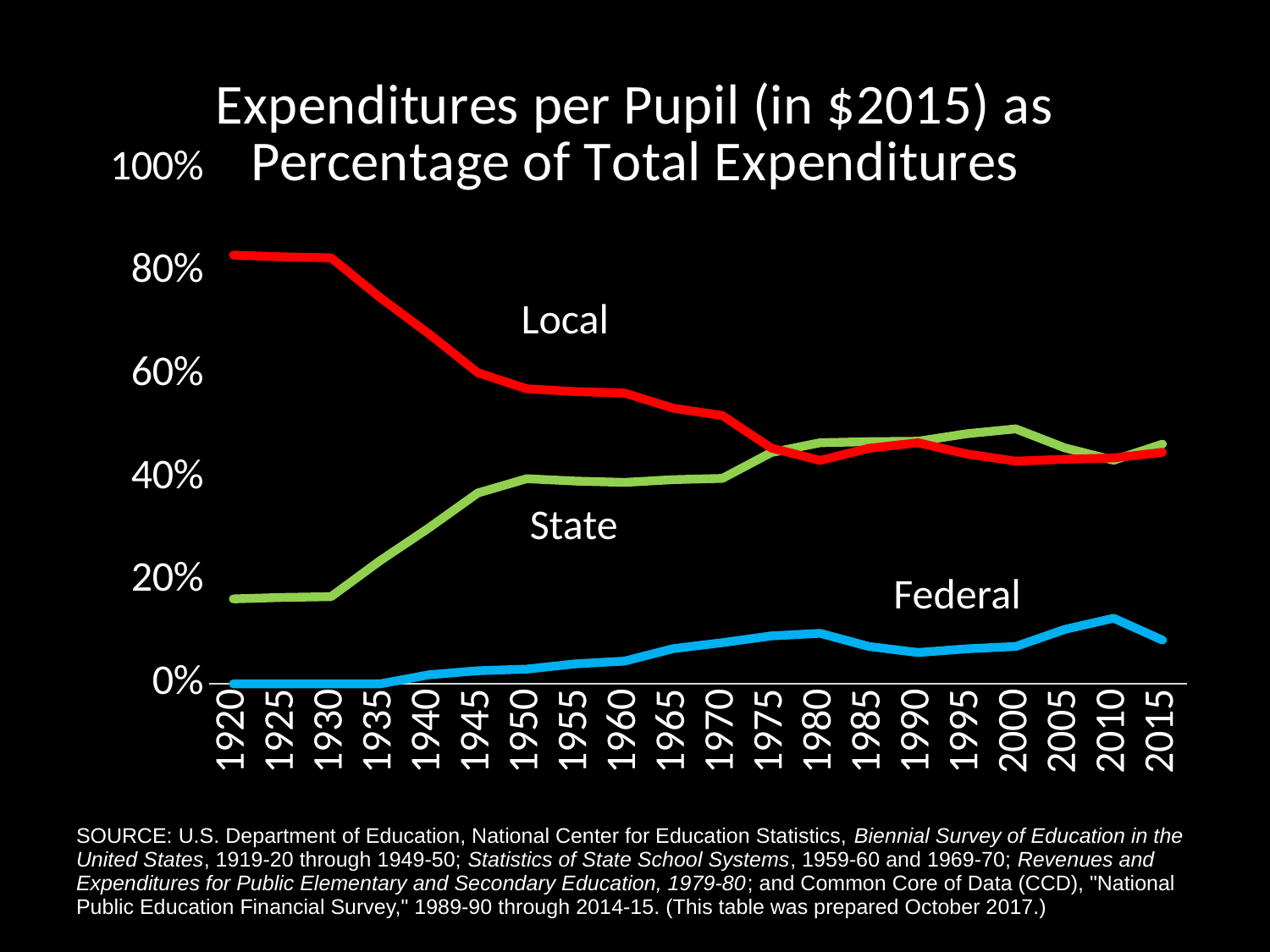
How many series are plotted on the chart? 3 What kind of chart is shown on the slide? line chart Is the value for Local in 1920 greater or less than 60%? greater Does the Local series rise or fall from 1920 to 2015? fall In 2015, which is larger, the State value or the Federal value? State Does the State series rise or fall from 1920 to 2015? rise Is the value for State in 1920 greater or less than 20%? less What colour is the Local line on the chart? red Is the value for Federal in 2015 greater or less than 20%? less Which series has the lowest value in 2015? Federal How many years are marked along the x axis of the chart? 20 In 1920, which is larger, the Local value or the State value? Local